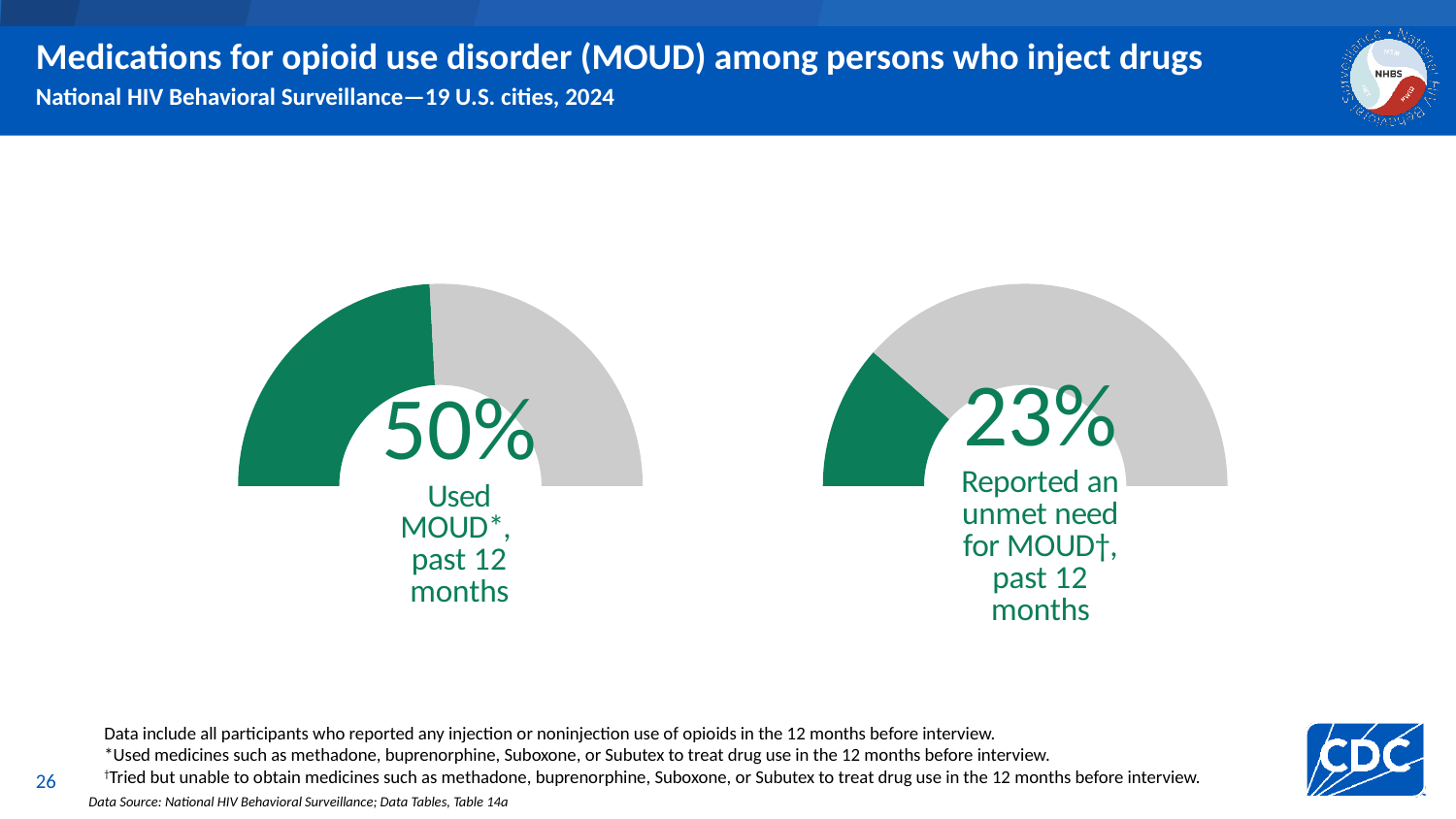
How many charts are shown on the slide? 2 Is the value shown in the right chart (unmet need for MOUD) greater or less than 50%? less What kind of chart is used to display the percentages on this slide? Donut chart What percentage of persons who inject drugs used MOUD in the past 12 months, according to the left chart? 50% Which is larger: the percentage who used MOUD or the percentage who reported an unmet need for MOUD? Used MOUD What is the title of the slide containing the two charts? Medications for opioid use disorder (MOUD) among persons who inject drugs What is the difference in percentage points between the share who used MOUD (left chart) and the share who reported an unmet need for MOUD (right chart)? 27 percentage points What percentage reported an unmet need for MOUD in the past 12 months, according to the right chart? 23% What colour is used for the filled (value) portion of each chart? Green